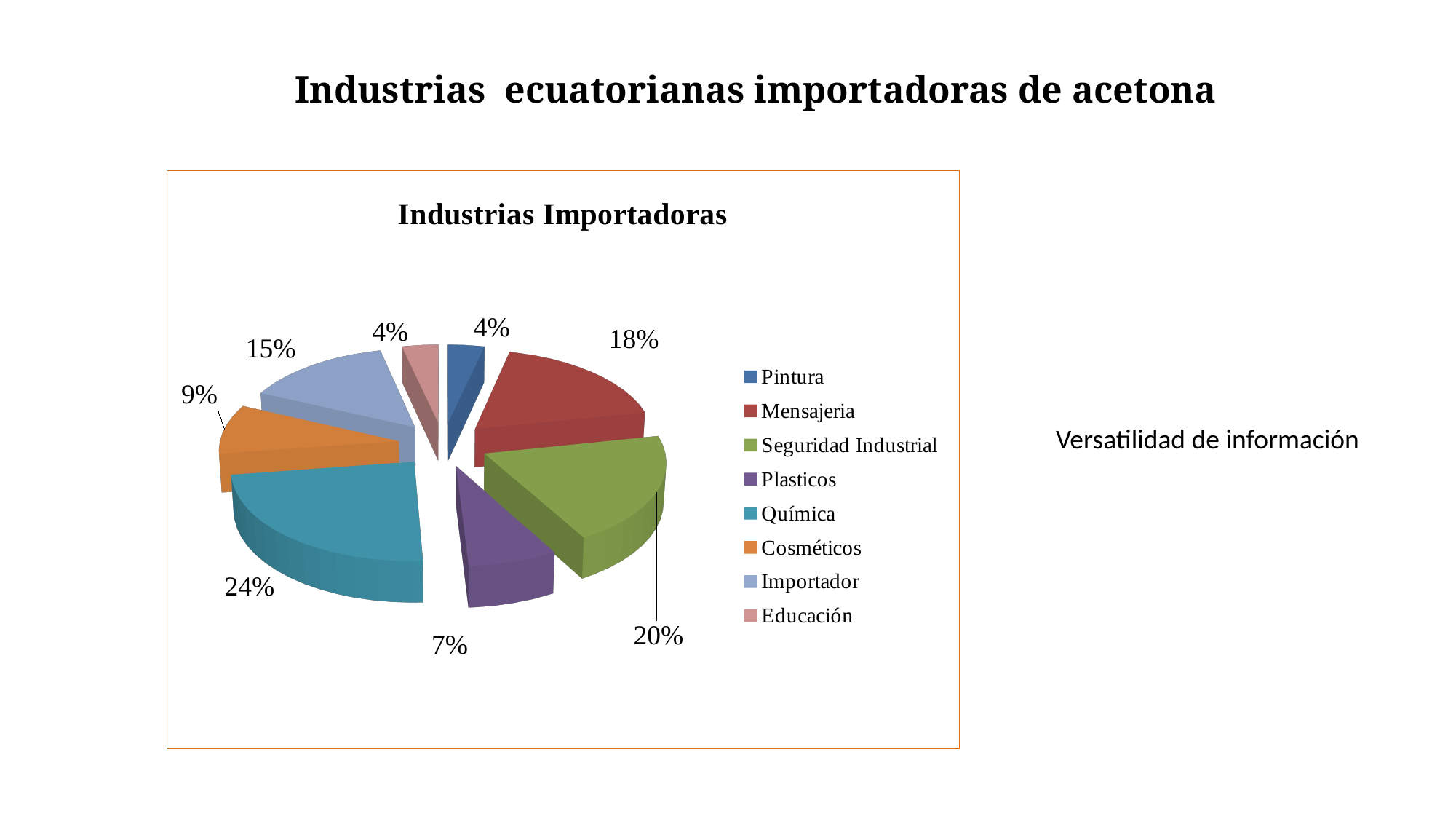
What is the difference between the shares of Química and Plasticos? 17% Which category has the largest share of the pie? Química What is the chart's title? Industrias Importadoras What colour is the slice for Cosméticos? orange What is the value for Importador? 15% What is the value for Mensajeria? 18% Which is larger, the share for Mensajeria or the share for Importador? Mensajeria What share of the pie does Seguridad Industrial represent? 20% How many categories does the legend list? 8 What is the value for Cosméticos? 9% What type of chart is shown on the slide? pie chart What share of the pie does Química represent? 24%